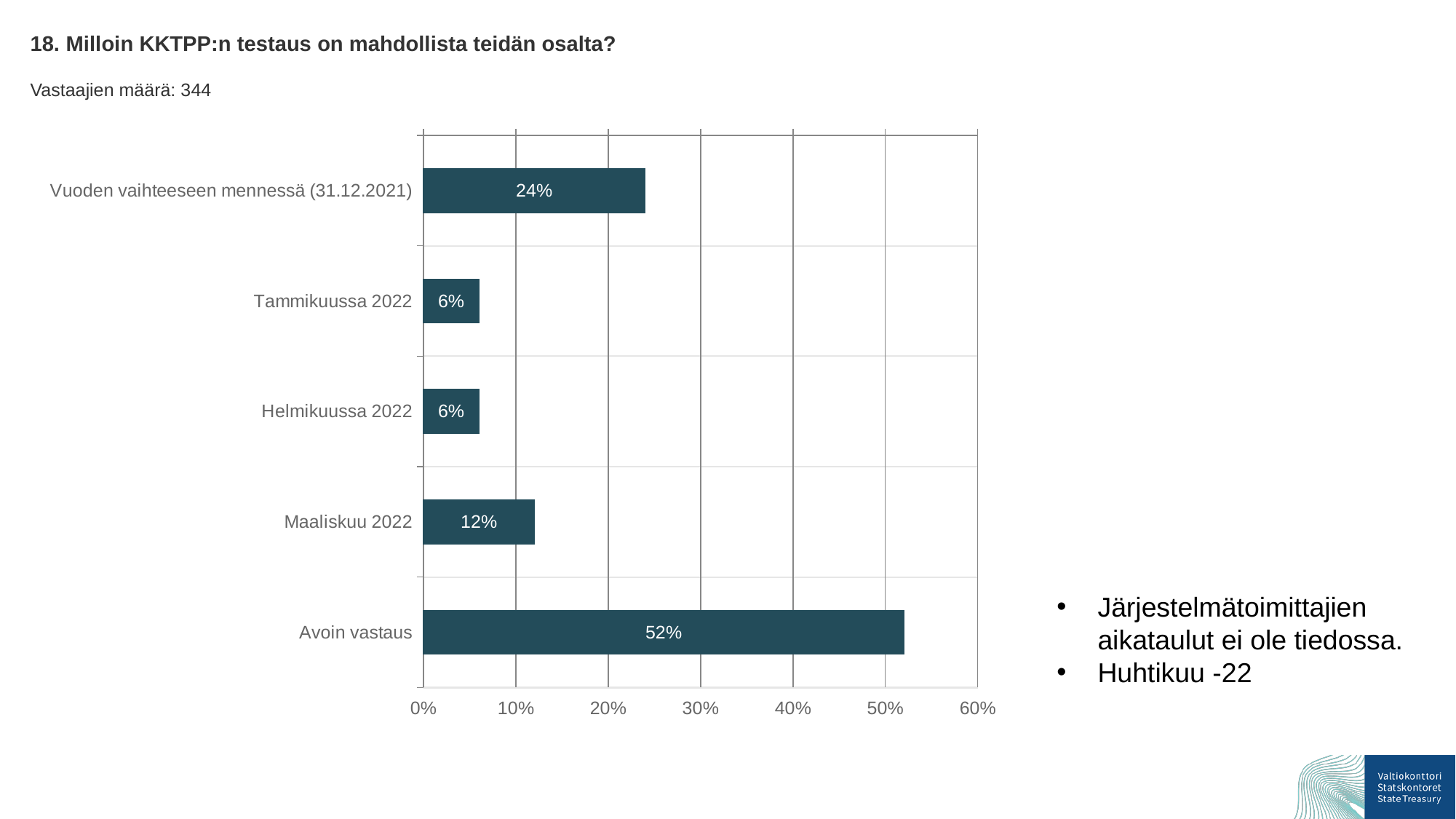
What is the value for "Maaliskuu 2022"? 12% What kind of chart is shown on the slide? bar chart How many categories are shown in the chart? 5 What percentage of respondents chose "Avoin vastaus"? 52% Which category has the highest value? Avoin vastaus How many respondents (Vastaajien määrä) are reported on the slide? 344 Is the value for "Avoin vastaus" greater or less than 50%? greater What is the value for "Vuoden vaihteeseen mennessä (31.12.2021)"? 24% Which is larger, the value for "Maaliskuu 2022" or the value for "Tammikuussa 2022"? Maaliskuu 2022 What is the difference between the values for "Avoin vastaus" and "Vuoden vaihteeseen mennessä (31.12.2021)"? 28% What is the difference between the values for "Maaliskuu 2022" and "Helmikuussa 2022"? 6% What is the value for "Tammikuussa 2022"? 6%